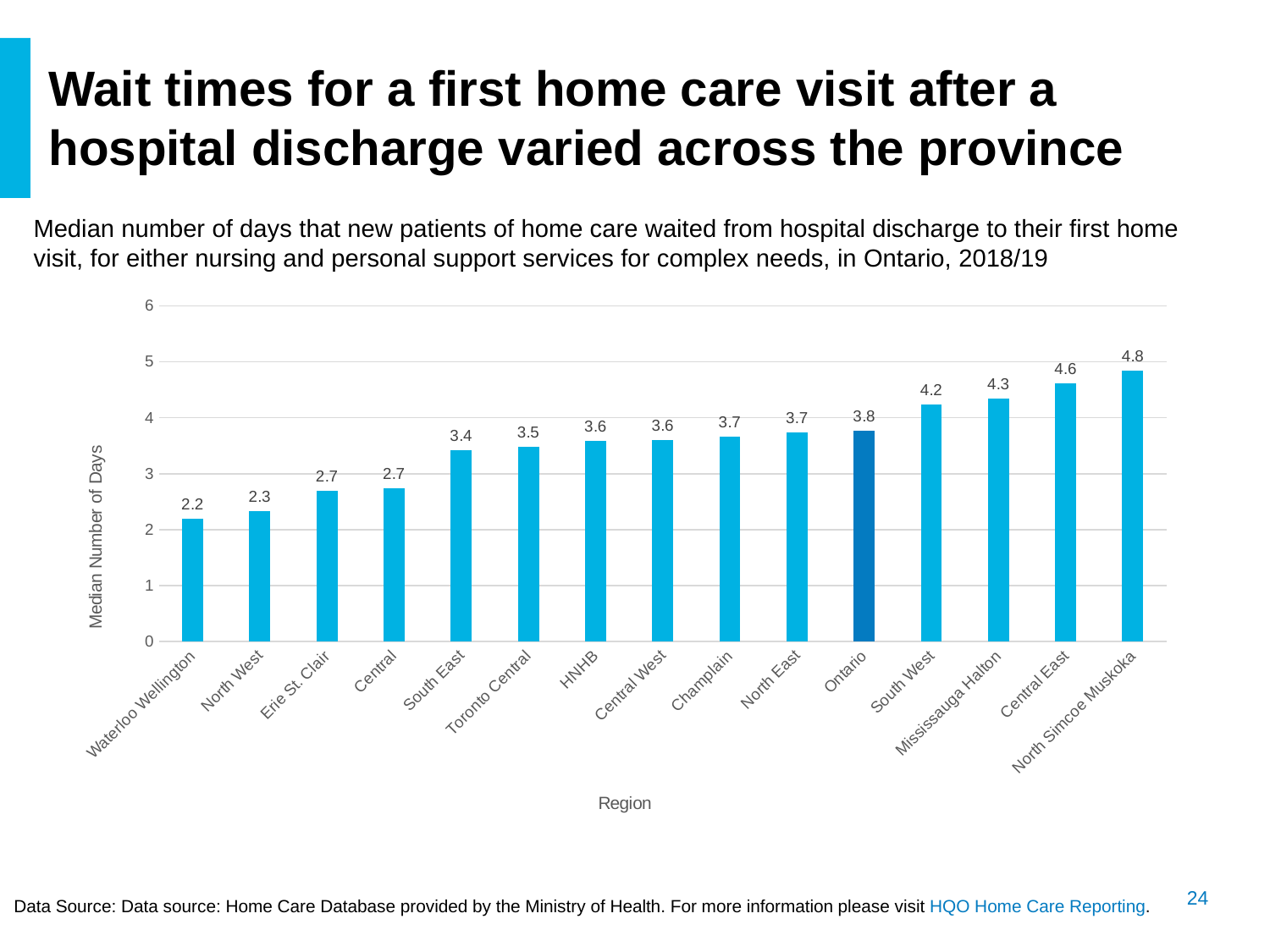
Do the values rise or fall from left to right along the x axis? Rise How many regions are shown on the x axis? 15 Which region has the highest median number of days? North Simcoe Muskoka What is the median number of days for Waterloo Wellington? 2.2 What kind of chart is shown on the slide? Bar chart What is the median number of days for Mississauga Halton? 4.3 Which region has the lowest median number of days? Waterloo Wellington What is the difference in median number of days between North Simcoe Muskoka and Waterloo Wellington? 2.6 What is the median number of days for Ontario? 3.8 Is the value for Champlain greater or less than 3? greater Which has a higher median number of days, South West or Central East? Central East Which bar is shown in a darker blue than the others? Ontario